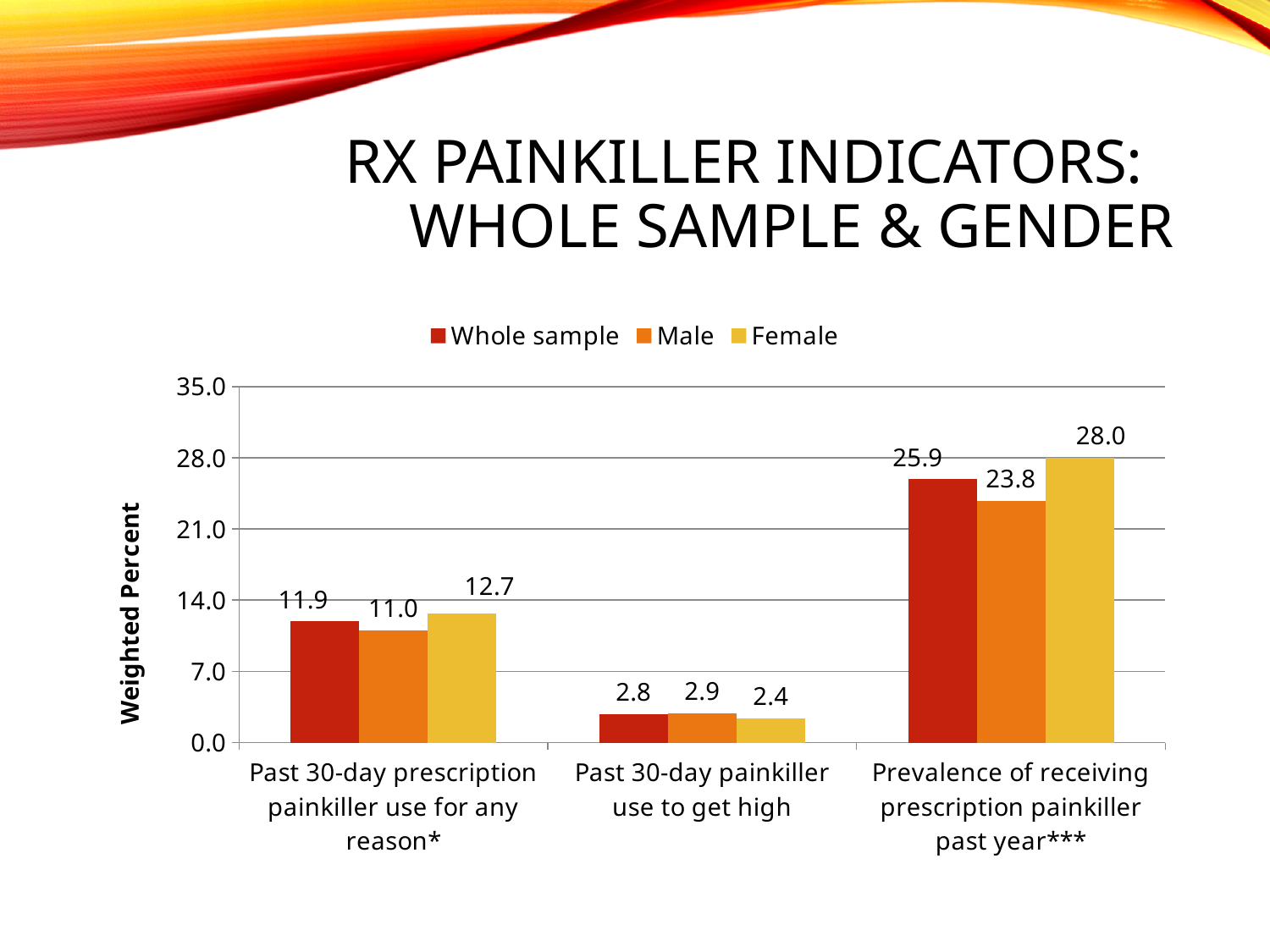
What is the Whole sample value for Past 30-day prescription painkiller use for any reason*? 11.9 What is the Female value for Prevalence of receiving prescription painkiller past year***? 28.0 What is the Male value for Past 30-day painkiller use to get high? 2.9 What is the label of the y axis? Weighted Percent Which category has the highest Whole sample value? Prevalence of receiving prescription painkiller past year*** Which category has the lowest Female value? Past 30-day painkiller use to get high How many series does the legend list? 3 What is the difference between the Female and Male values for Prevalence of receiving prescription painkiller past year***? 4.2 What kind of chart is shown on the slide? Bar chart What is the difference between the Whole sample and Male values for Past 30-day prescription painkiller use for any reason*? 0.9 How many categories are shown on the x axis? 3 For Past 30-day prescription painkiller use for any reason*, which is larger: the Male value or the Female value? Female